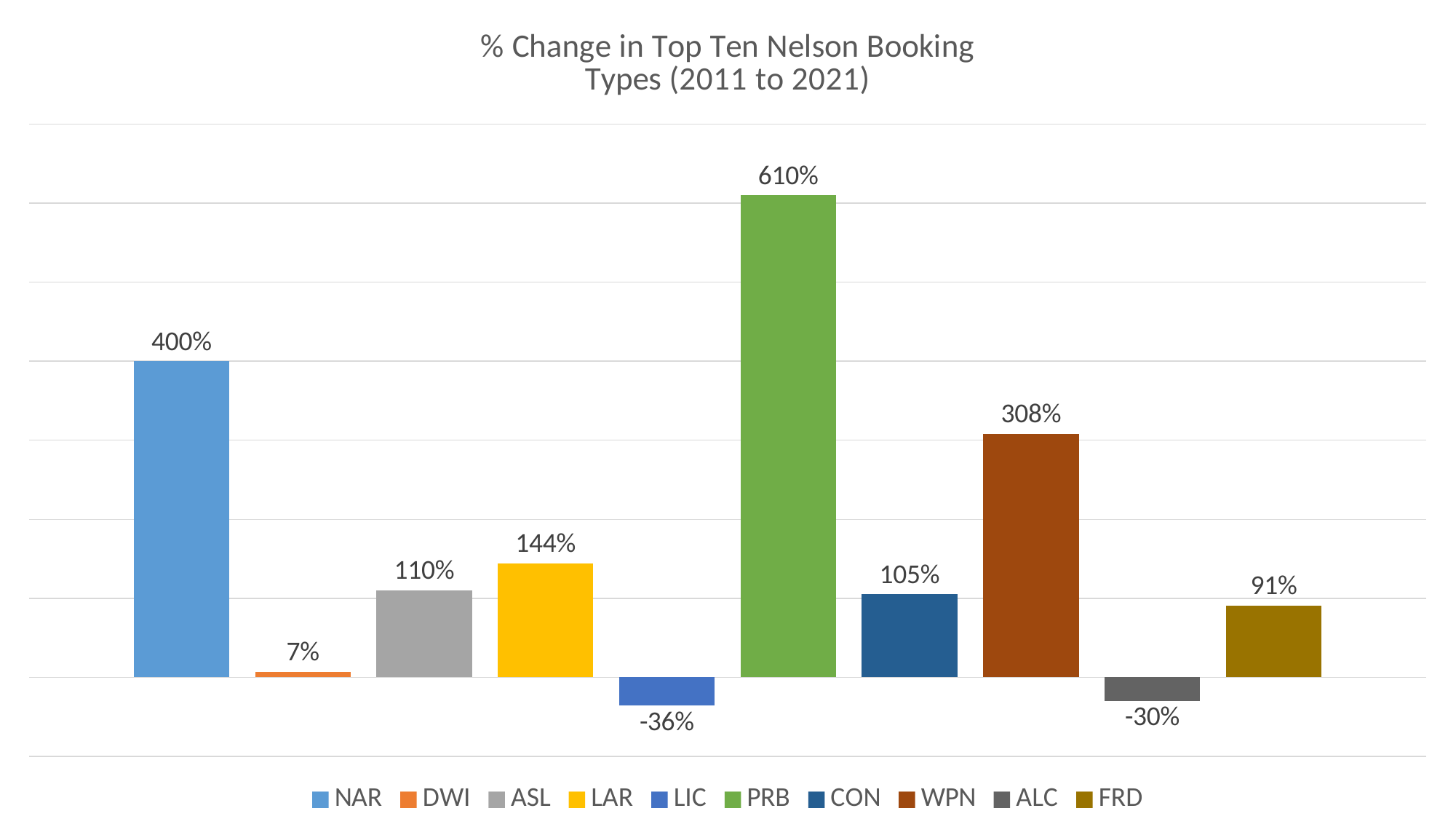
Which has a larger % change, CON or FRD? CON What is the difference between the % change for NAR and the % change for WPN? 92% What is the title of the chart? % Change in Top Ten Nelson Booking Types (2011 to 2021) Which booking type has the lowest % change? LIC What is the % change for DWI? 7% What kind of chart is this? Bar chart Which booking type has the highest % change? PRB What is the % change for PRB? 610% What is the % change for WPN? 308% Which has a larger % change, LAR or ASL? LAR What is the % change for LIC? -36% How many booking types are shown in the chart? 10